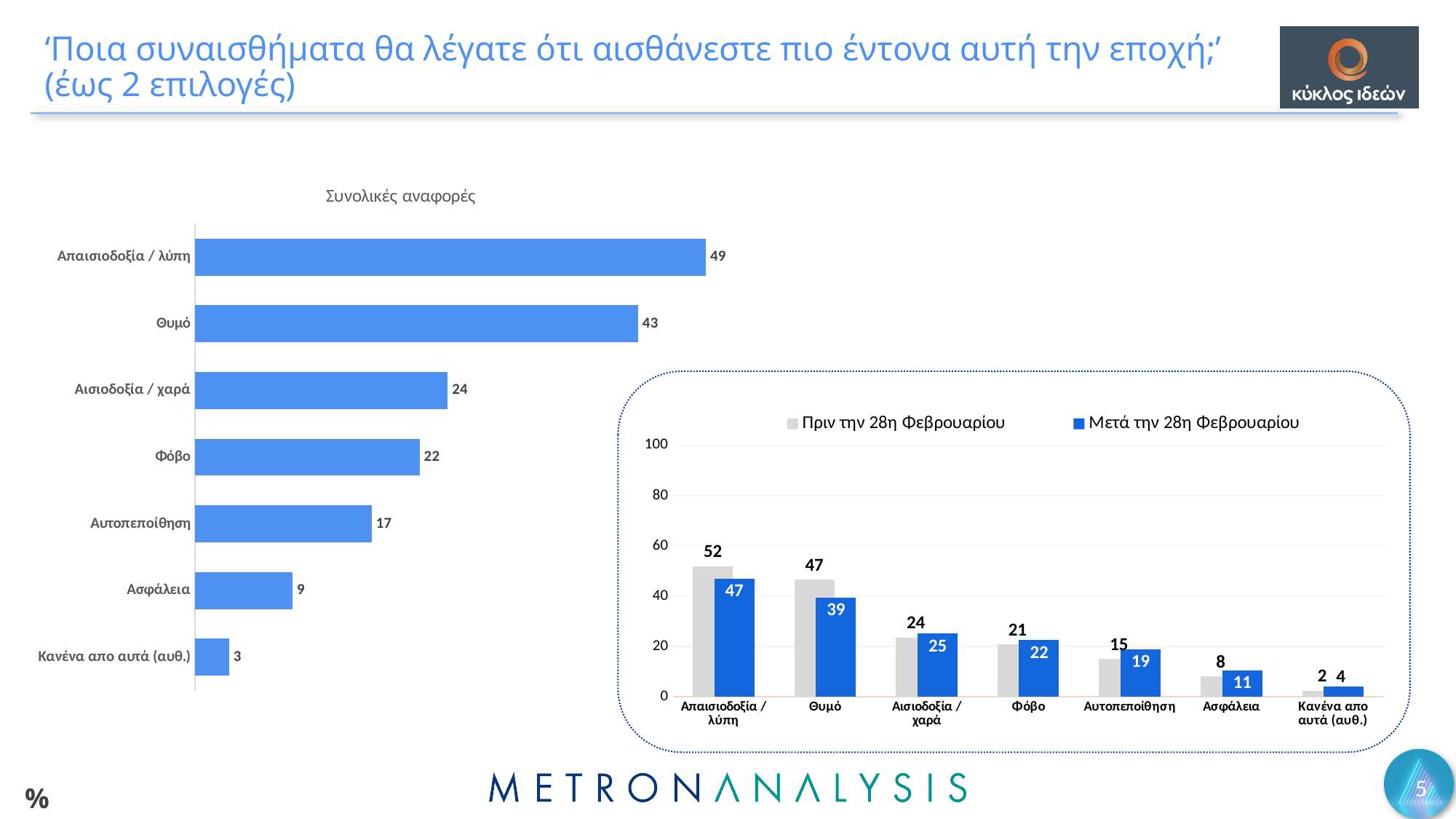
In the right chart, what is the value for Αυτοπεποίθηση in the 'Πριν την 28η Φεβρουαρίου' series? 15 In the right chart, which is larger for Θυμό: 'Πριν την 28η Φεβρουαρίου' or 'Μετά την 28η Φεβρουαρίου'? Πριν την 28η Φεβρουαρίου In the left chart titled 'Συνολικές αναφορές', which category has the lowest value? Κανένα απο αυτά (αυθ.) In the right chart, what is the value for Φόβο in the 'Μετά την 28η Φεβρουαρίου' series? 22 In the left chart titled 'Συνολικές αναφορές', what is the difference between Απαισιοδοξία / λύπη and Αισιοδοξία / χαρά? 25 In the left chart titled 'Συνολικές αναφορές', which category has the highest value? Απαισιοδοξία / λύπη What kind of chart is the left chart titled 'Συνολικές αναφορές'? Bar chart In the left chart titled 'Συνολικές αναφορές', what is the value for Θυμό? 43 In the left chart titled 'Συνολικές αναφορές', how many categories are shown? 7 In the right chart, what is the difference between the 'Πριν' and 'Μετά' values for Απαισιοδοξία / λύπη? 5 In the right chart, what colour are the bars for the 'Μετά την 28η Φεβρουαρίου' series? Blue In the right chart, how many series does the legend list? 2